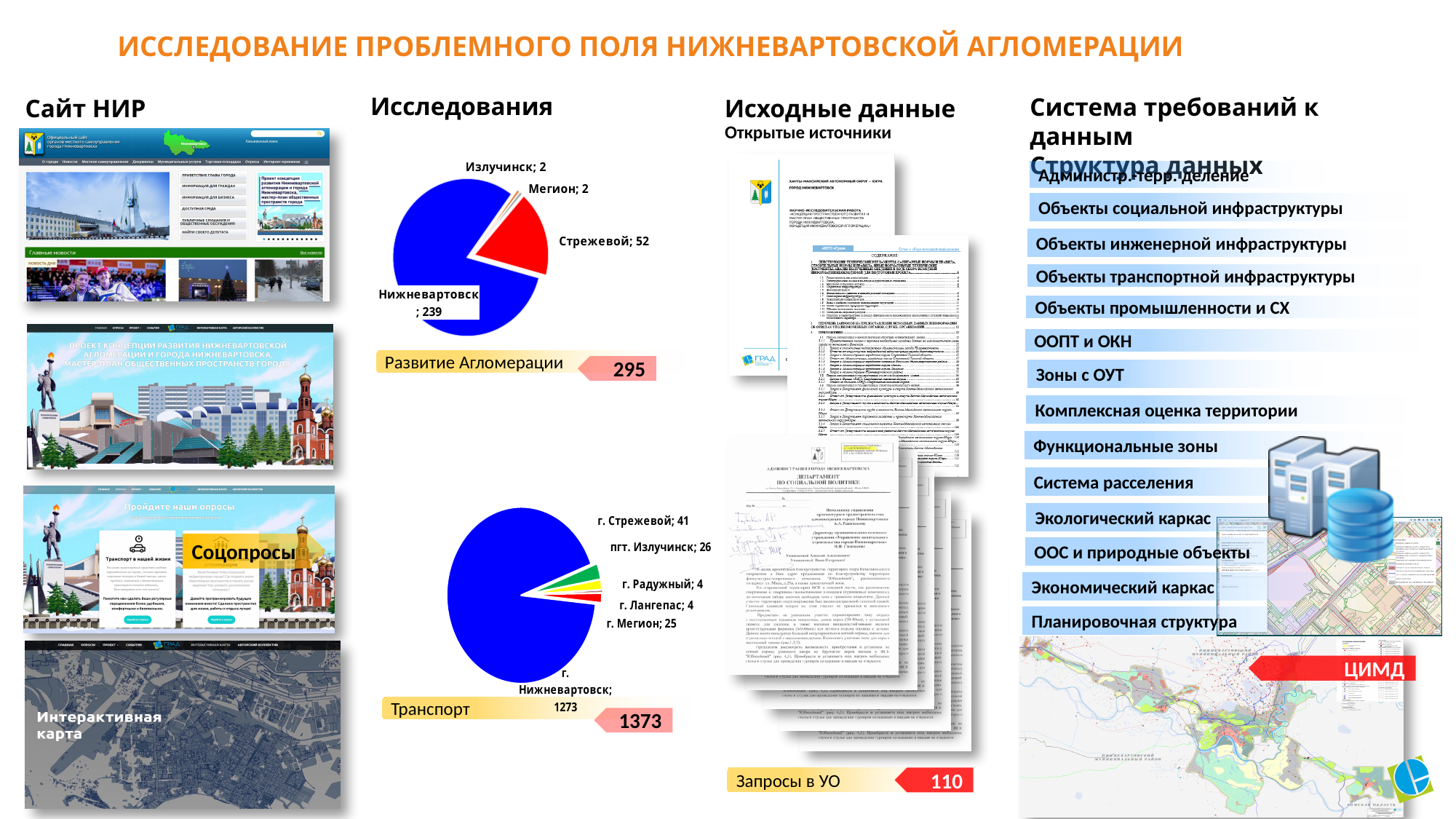
In the top pie chart (Развитие Агломерации), what is the value for Нижневартовск? 239 How many categories are shown in the bottom pie chart (Транспорт)? 6 In the bottom pie chart (Транспорт), what is the value for г. Стрежевой? 41 What type of chart is used for the Транспорт data at the bottom of the Исследования column? Pie chart In the top pie chart (Развитие Агломерации), what is the difference between the values for Нижневартовск and Стрежевой? 187 In the top pie chart (Развитие Агломерации), which category has the largest slice? Нижневартовск In the top pie chart (Развитие Агломерации), what is the value for Стрежевой? 52 In the bottom pie chart (Транспорт), what is the difference between the values for пгт. Излучинск and г. Мегион? 1 How many categories are shown in the top pie chart (Развитие Агломерации)? 4 In the bottom pie chart (Транспорт), what is the value for г. Нижневартовск? 1273 In the bottom pie chart (Транспорт), what is the value for пгт. Излучинск? 26 In the bottom pie chart (Транспорт), which is larger, г. Стрежевой or г. Мегион? г. Стрежевой